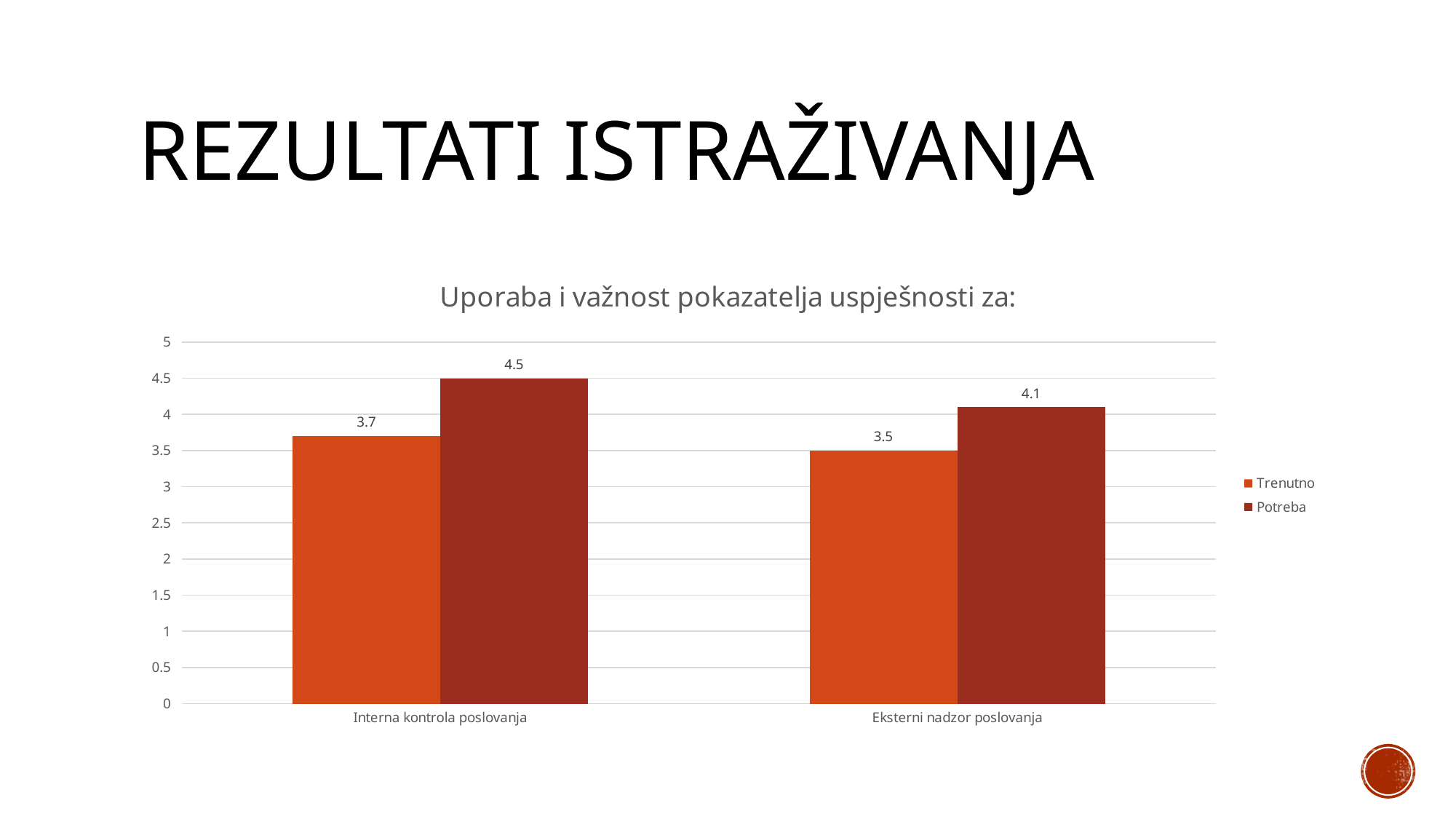
What is the Potreba value for Eksterni nadzor poslovanja? 4.1 What is the Trenutno value for Eksterni nadzor poslovanja? 3.5 What is the difference between the Potreba and Trenutno values for Eksterni nadzor poslovanja? 0.6 What is the Potreba value for Interna kontrola poslovanja? 4.5 What is the Trenutno value for Interna kontrola poslovanja? 3.7 What is the difference between the Potreba and Trenutno values for Interna kontrola poslovanja? 0.8 How many series does the legend list? 2 Which is larger for Eksterni nadzor poslovanja, Trenutno or Potreba? Potreba What kind of chart is shown on the slide? Bar chart How many categories are shown on the x axis? 2 Which category has the lowest Trenutno value? Eksterni nadzor poslovanja Which category has the highest Potreba value? Interna kontrola poslovanja